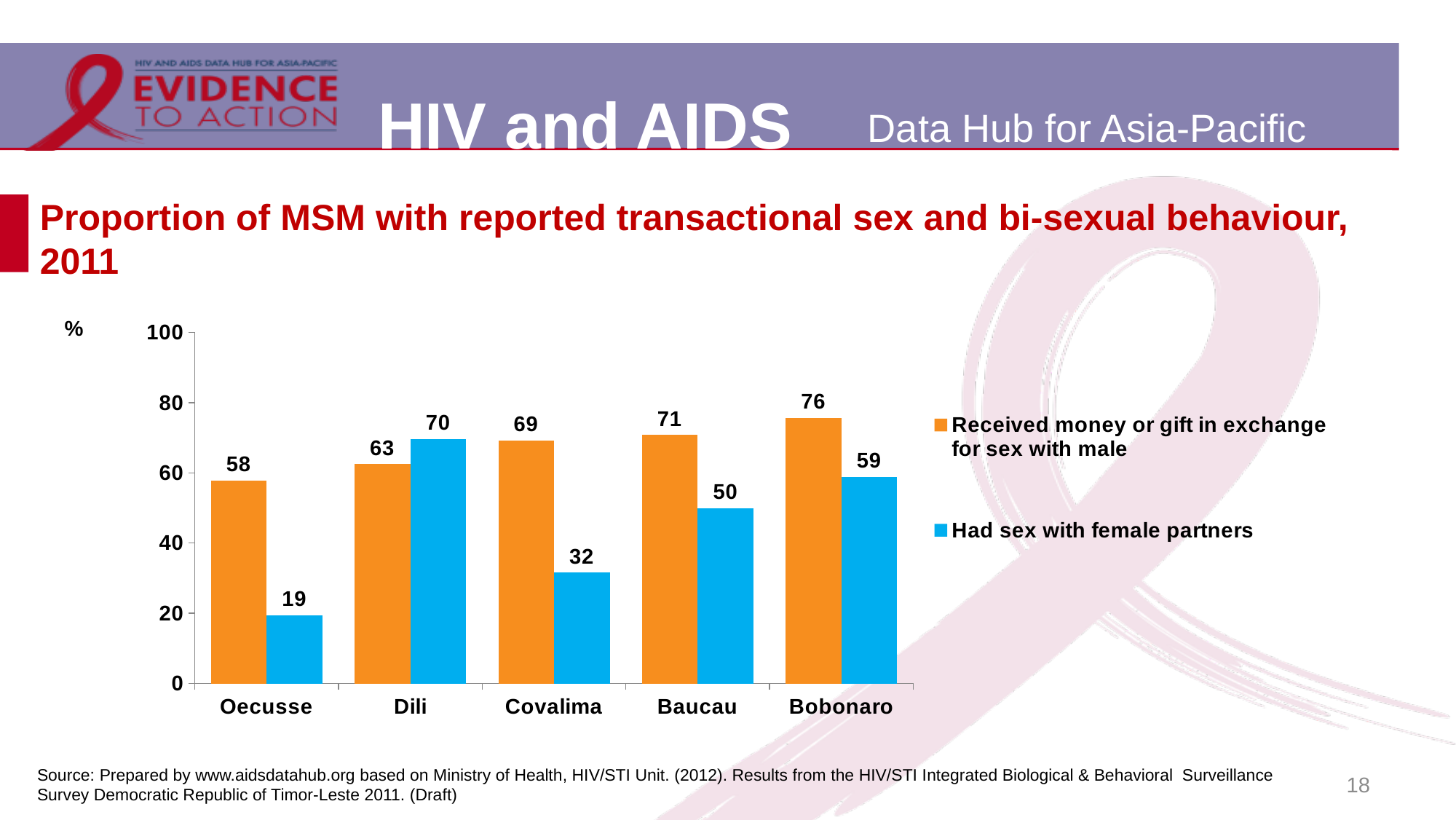
What is the value for 'Had sex with female partners' in Bobonaro? 59 How many districts are shown on the x axis? 5 Which district has the lowest value for 'Had sex with female partners'? Oecusse In Dili, which series has the larger value: 'Received money or gift in exchange for sex with male' or 'Had sex with female partners'? Had sex with female partners What is the value for 'Received money or gift in exchange for sex with male' in Oecusse? 58 Does the value for 'Received money or gift in exchange for sex with male' rise or fall from Oecusse to Bobonaro? Rise How many series does the legend list? 2 What colour are the bars for 'Had sex with female partners'? Blue What is the value for 'Had sex with female partners' in Covalima? 32 What is the difference between the two series values in Oecusse? 39 What kind of chart is shown on the slide? Bar chart Which district has the highest value for 'Received money or gift in exchange for sex with male'? Bobonaro